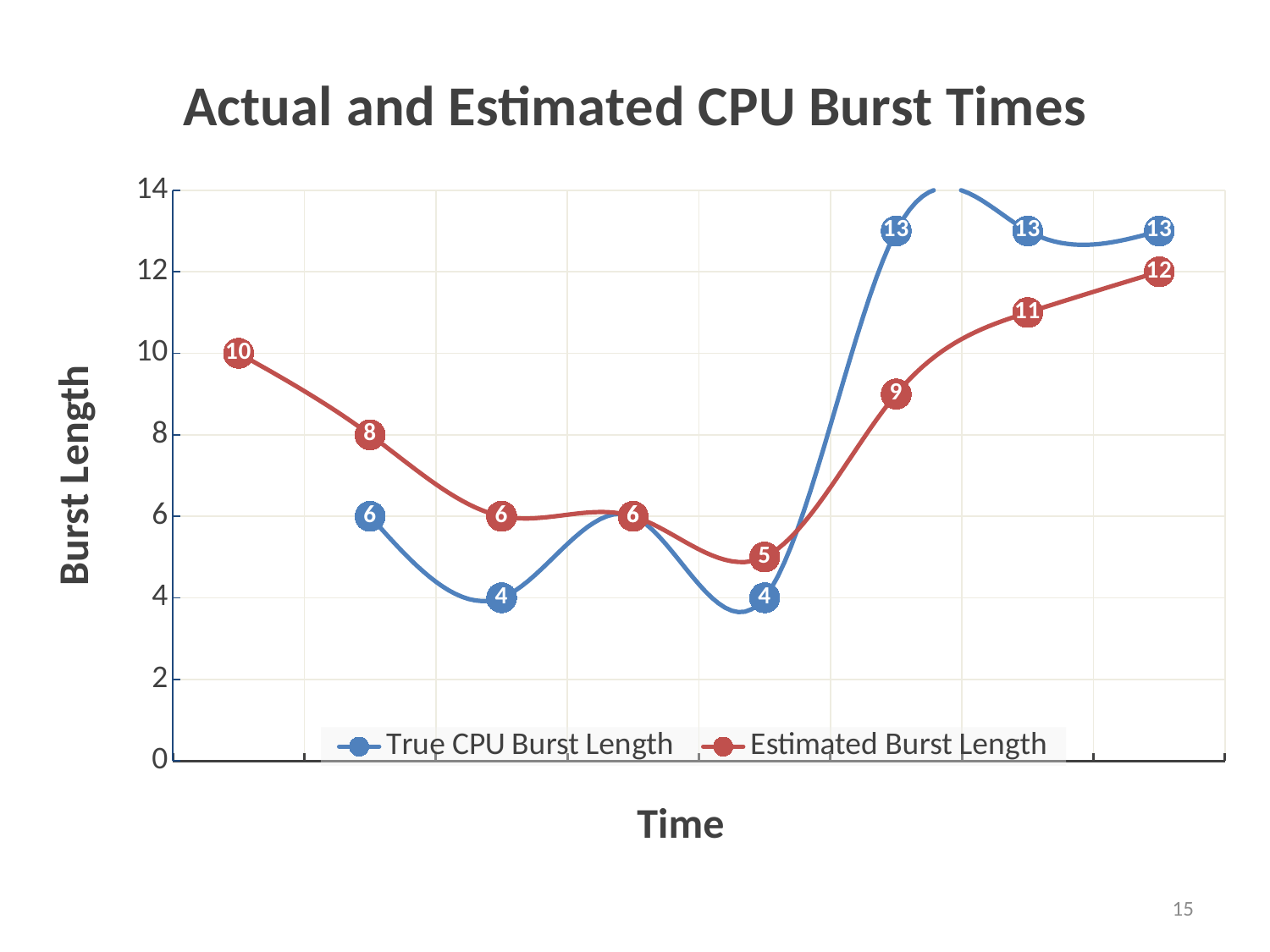
How many data points are plotted for the Estimated Burst Length series? 8 What is the lowest value plotted for the True CPU Burst Length series? 4 At the final time point, what is the difference between the True CPU Burst Length (13) and the Estimated Burst Length (12)? 1 At the final time point, which series has the larger value, True CPU Burst Length or Estimated Burst Length? True CPU Burst Length What is the lowest value plotted for the Estimated Burst Length series? 5 What is the title of the chart? Actual and Estimated CPU Burst Times What is the first plotted value of the Estimated Burst Length series? 10 What is the last plotted value of the True CPU Burst Length series? 13 What type of chart is shown on the slide? line chart What is the last plotted value of the Estimated Burst Length series? 12 What is the highest value plotted for the Estimated Burst Length series? 12 How many series does the legend list? 2